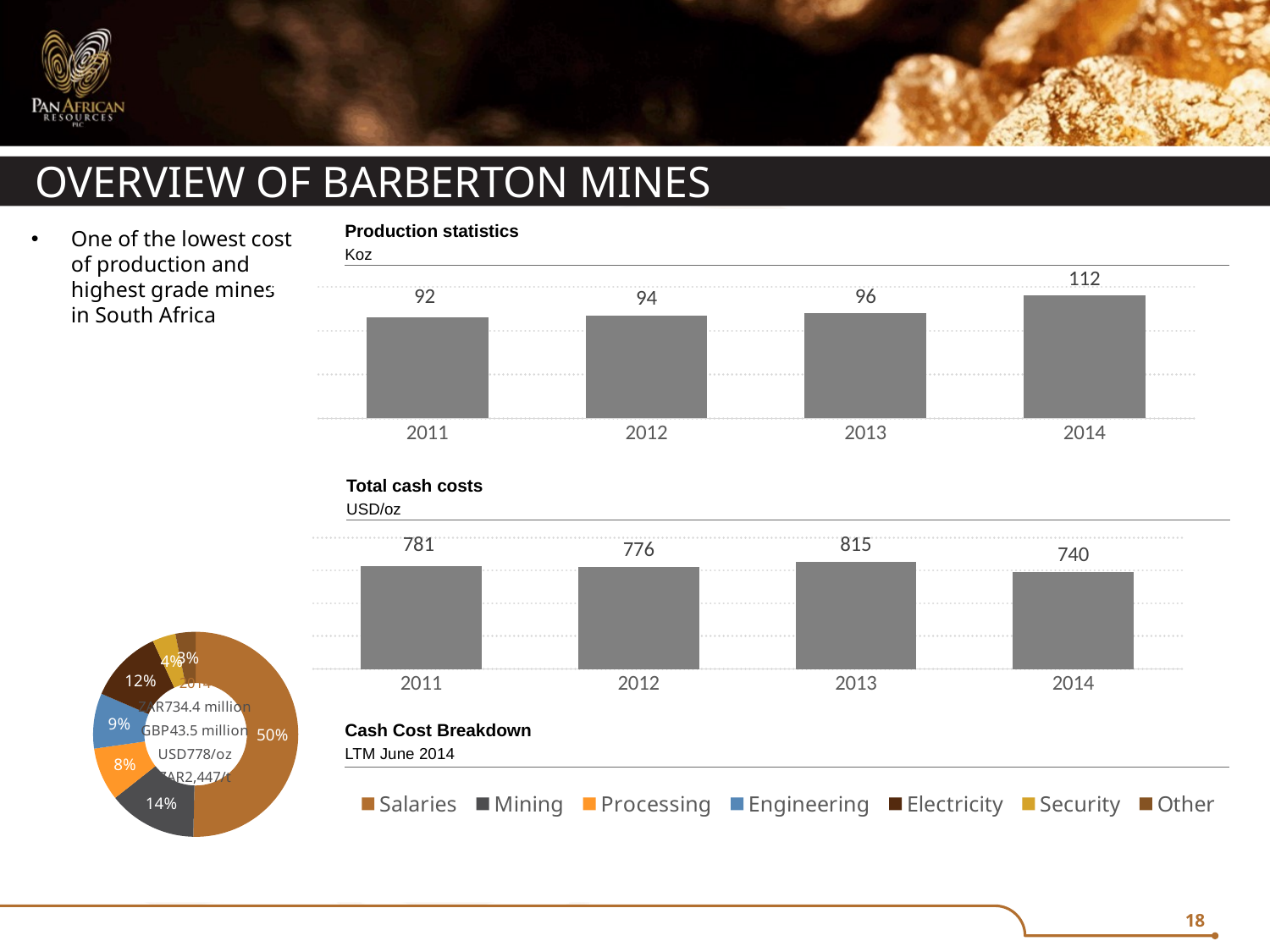
In the Total cash costs chart, how many years are plotted? 4 In the Production statistics chart, what unit is shown on the axis label? Koz In the Production statistics chart, what was production in 2014? 112 In the Production statistics chart, what is the difference between 2014 and 2013 production? 16 In the Production statistics chart, which year had the lowest production? 2011 In the Total cash costs chart, which year had the highest total cash cost? 2013 In the Cash Cost Breakdown chart, what share of cash costs is Salaries? 50% In the Cash Cost Breakdown chart, how many categories does the legend list? 7 In the Production statistics chart, do values rise or fall from 2011 to 2014? rise In the Total cash costs chart, what is the difference between the 2013 and 2014 values? 75 In the Total cash costs chart, what was the total cash cost in 2013? 815 In the Total cash costs chart, which year had the lowest total cash cost? 2014